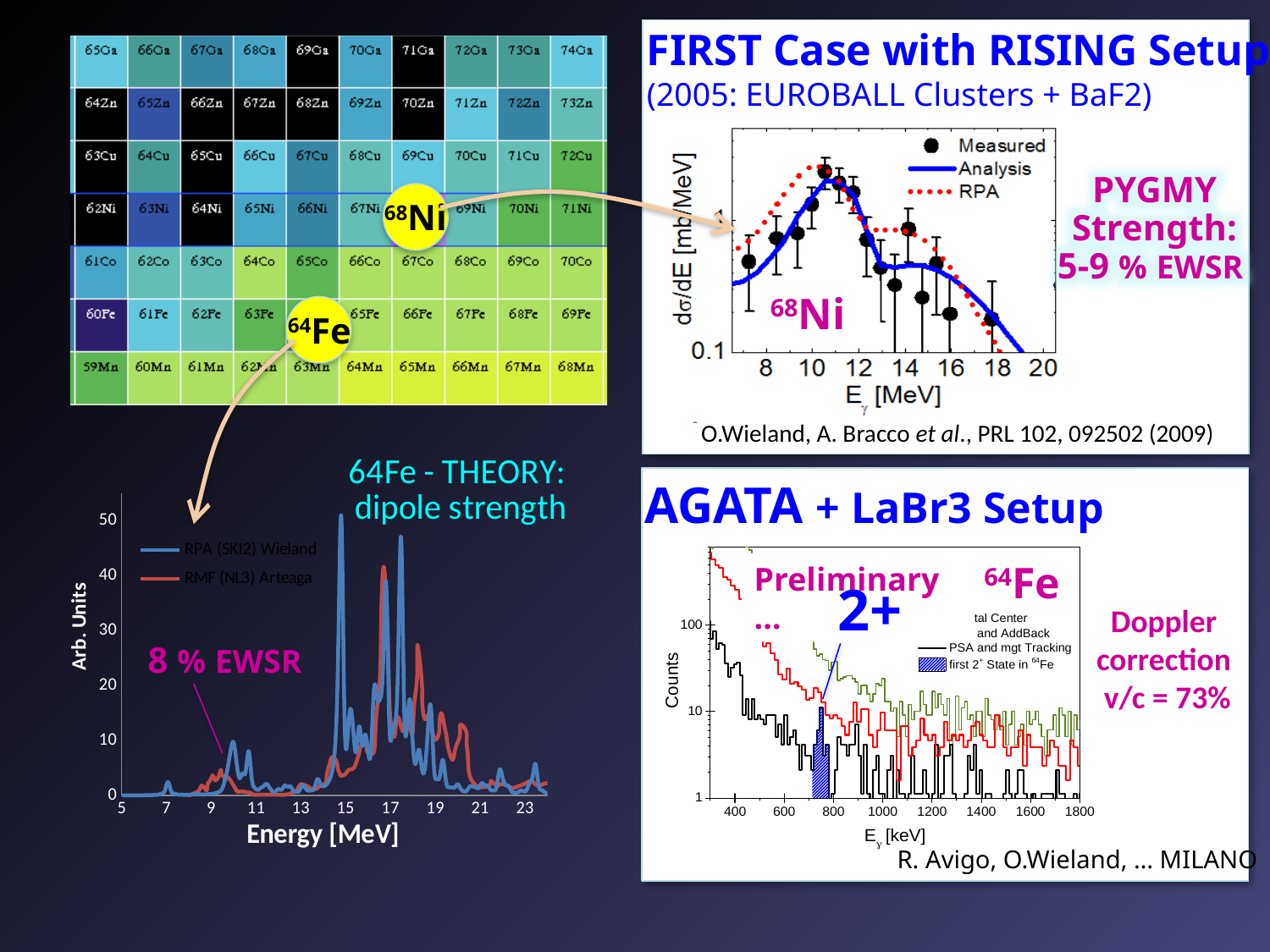
How many series does the legend of the 68Ni chart in the 'FIRST Case with RISING Setup' panel list? 3 In the '64Fe - THEORY: dipole strength' chart, is the value of the RMF (NL3) Arteaga series at 7 MeV greater or less than 10? less In the '64Fe - THEORY: dipole strength' chart, which series reaches the higher peak near 15 MeV? RPA (SKI2) Wieland How many series does the legend of the '64Fe - THEORY: dipole strength' chart list? 2 What are the legend entries of the 68Ni chart in the 'FIRST Case with RISING Setup' panel? Measured, Analysis, RPA What Pygmy strength range is stated next to the 68Ni chart? 5-9 % EWSR In the '64Fe - THEORY: dipole strength' chart, is the highest peak of the RPA (SKI2) Wieland series greater or less than 40? greater In the 68Ni chart, does the Analysis curve rise or fall between 12 and 20 MeV? fall What kind of chart is the '64Fe - THEORY: dipole strength' chart at the bottom left? line chart What v/c value is given for the Doppler correction next to the 'AGATA + LaBr3 Setup' chart? 73% What are the two legend entries in the '64Fe - THEORY: dipole strength' chart? RPA (SKI2) Wieland and RMF (NL3) Arteaga What EWSR percentage is annotated on the '64Fe - THEORY: dipole strength' chart? 8 % EWSR